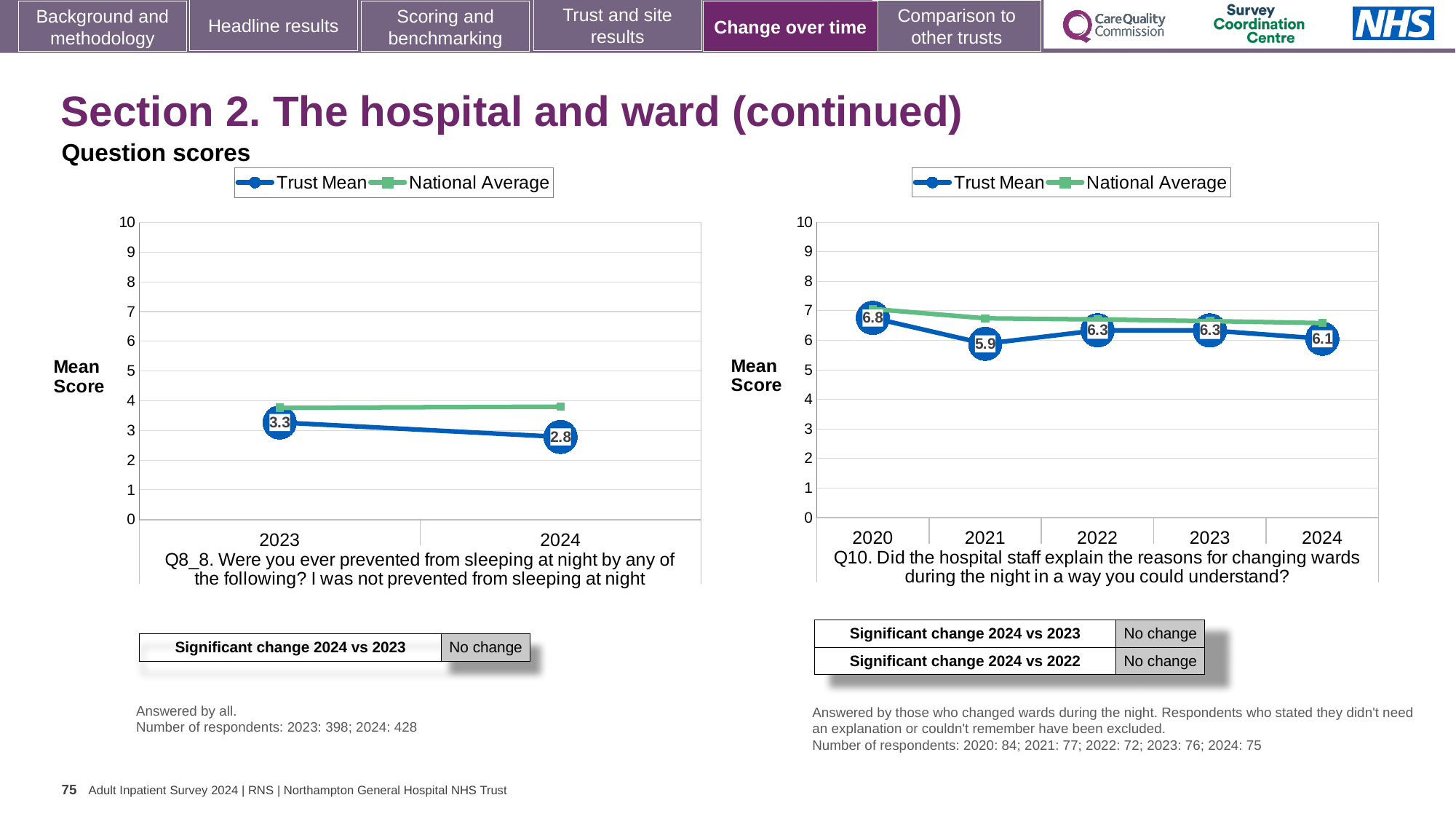
In the right chart (Q10), which year has the highest Trust Mean? 2020 In the right chart (Q10), what is the difference between the Trust Mean in 2020 and in 2021? 0.9 In the left chart (Q8_8), by how much did the Trust Mean fall from 2023 to 2024? 0.5 In the right chart (Q10), how many years are plotted on the x axis? 5 In the right chart (Q10), is the National Average for 2020 greater or less than 6? greater How many series does the legend of the left chart list? 2 In the right chart (Q10), what is the Trust Mean for 2024? 6.1 In the right chart (Q10), what is the Trust Mean for 2021? 5.9 In the left chart (Q8_8), what is the Trust Mean for 2024? 2.8 In the left chart (Q8_8), is the National Average for 2024 greater or less than 3? greater In the right chart (Q10), which year has the lowest Trust Mean? 2021 In the left chart (Q8_8), what is the Trust Mean for 2023? 3.3